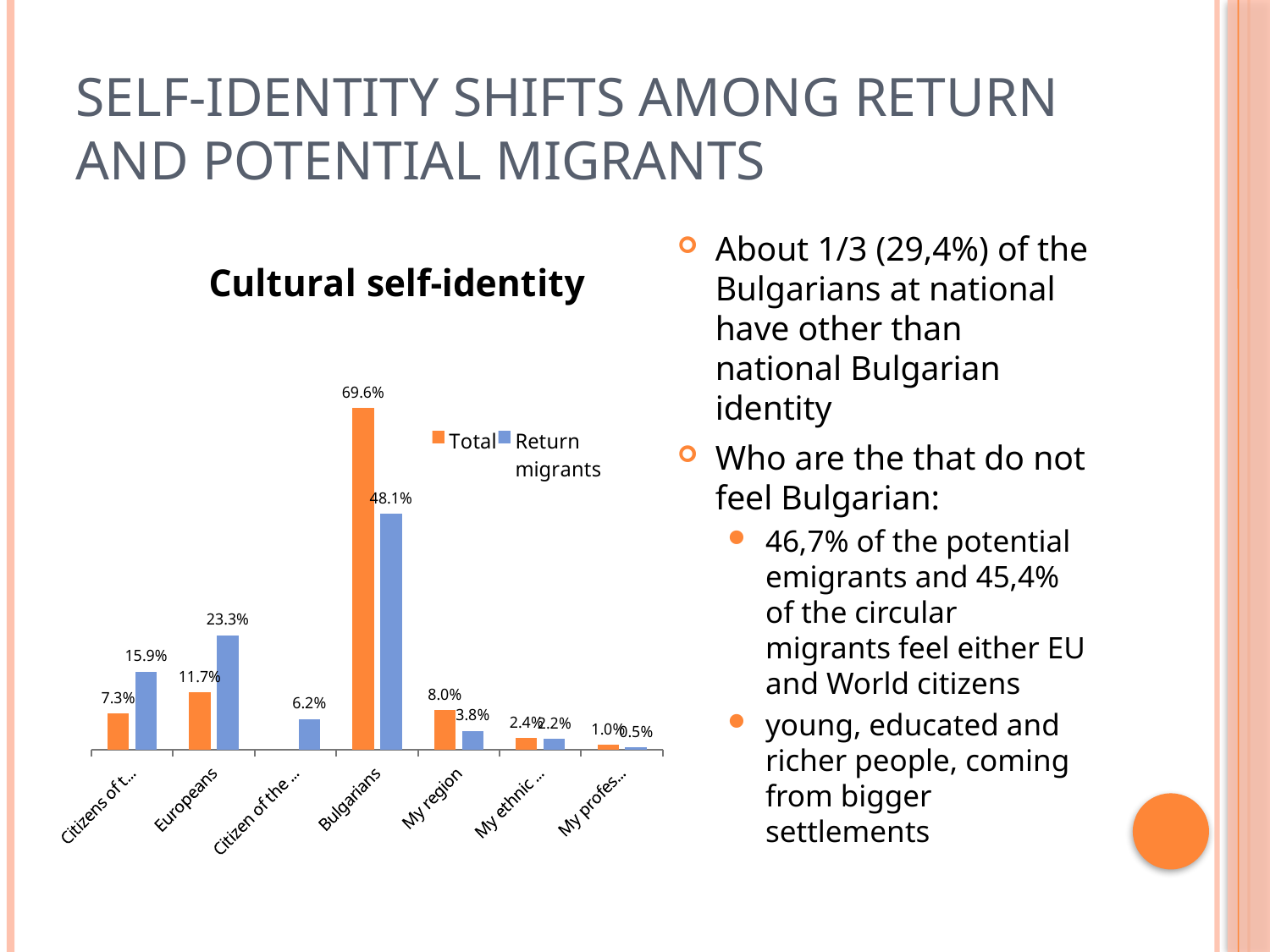
What is the Return migrants value for Bulgarians? 48.1% What is the difference between the Total and Return migrants values for Bulgarians? 21.5% Which category has the highest Total value? Bulgarians What is the Total value for Bulgarians in the Cultural self-identity chart? 69.6% What is the Return migrants value for Europeans? 23.3% What is the Total value for Europeans? 11.7% For My region, which series has the larger value, Total or Return migrants? Total What is the title of the chart? Cultural self-identity What kind of chart is shown on the slide? Bar chart How many series does the legend list? 2 For Europeans, which series has the larger value, Total or Return migrants? Return migrants What is the Total value for My region? 8.0%